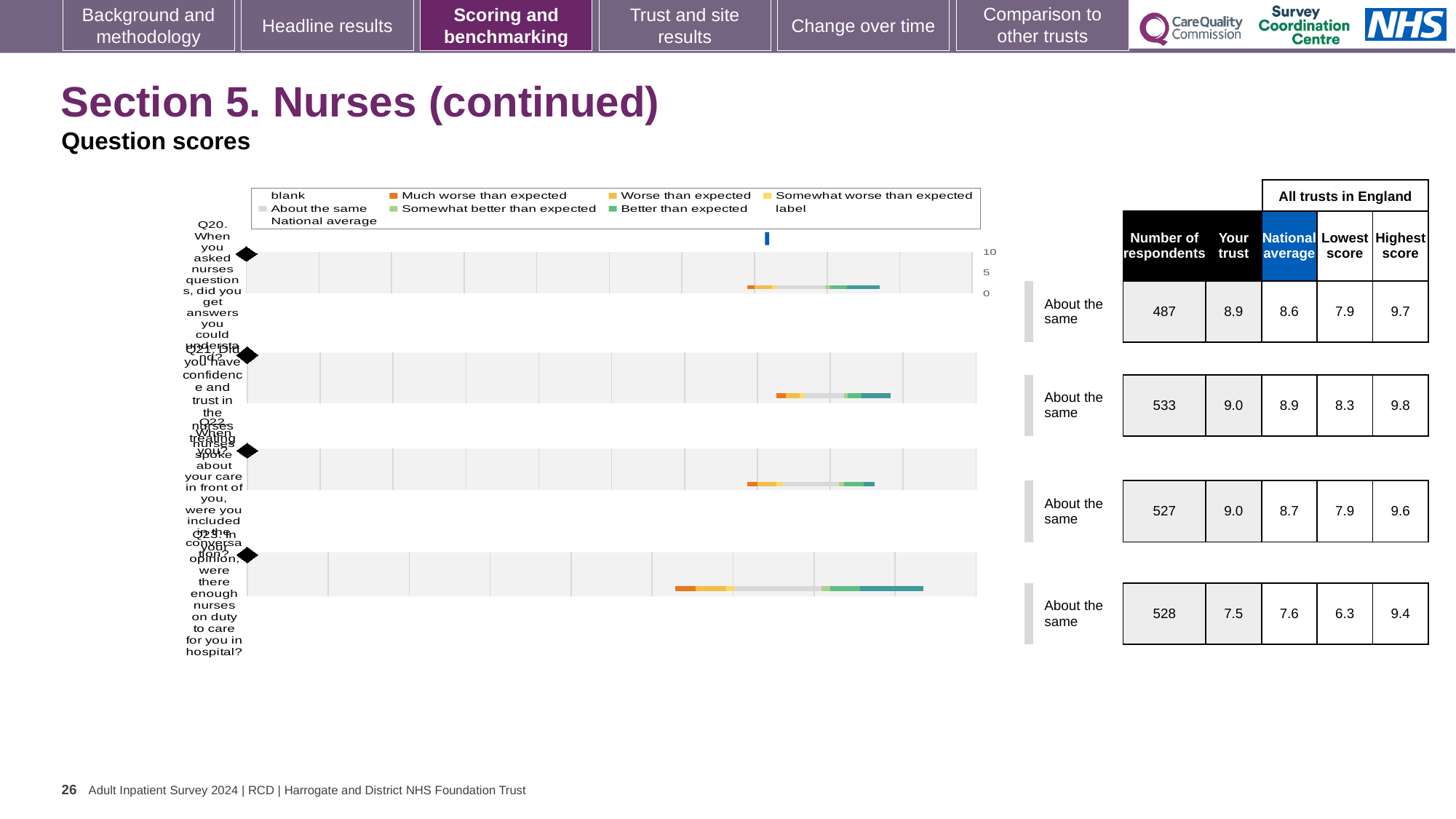
What is the highest tick value shown on the axis of the Q20 chart? 10 In the table beside the charts, what is the national average for Q23 (enough nurses on duty)? 7.6 How many question charts (Q20 to Q23) are shown on the slide? 4 In the table beside the charts, what is the 'Your trust' score for Q21 (confidence and trust in the nurses)? 9.0 Which legend entry is shown in orange? Much worse than expected How many entries does the legend above the charts list? 9 In the table beside the charts, which question has the lowest 'Your trust' score? Q23 In the table beside the charts, is the 'Your trust' score for Q20 larger or smaller than the national average for Q20? larger What kind of chart is used for the question scores on this slide? bar chart What benchmark category is given for each of the four questions on the slide? About the same In the table beside the charts, what is the difference between the highest score and the lowest score for Q22? 1.7 In the table beside the charts, what is the number of respondents for Q20? 487